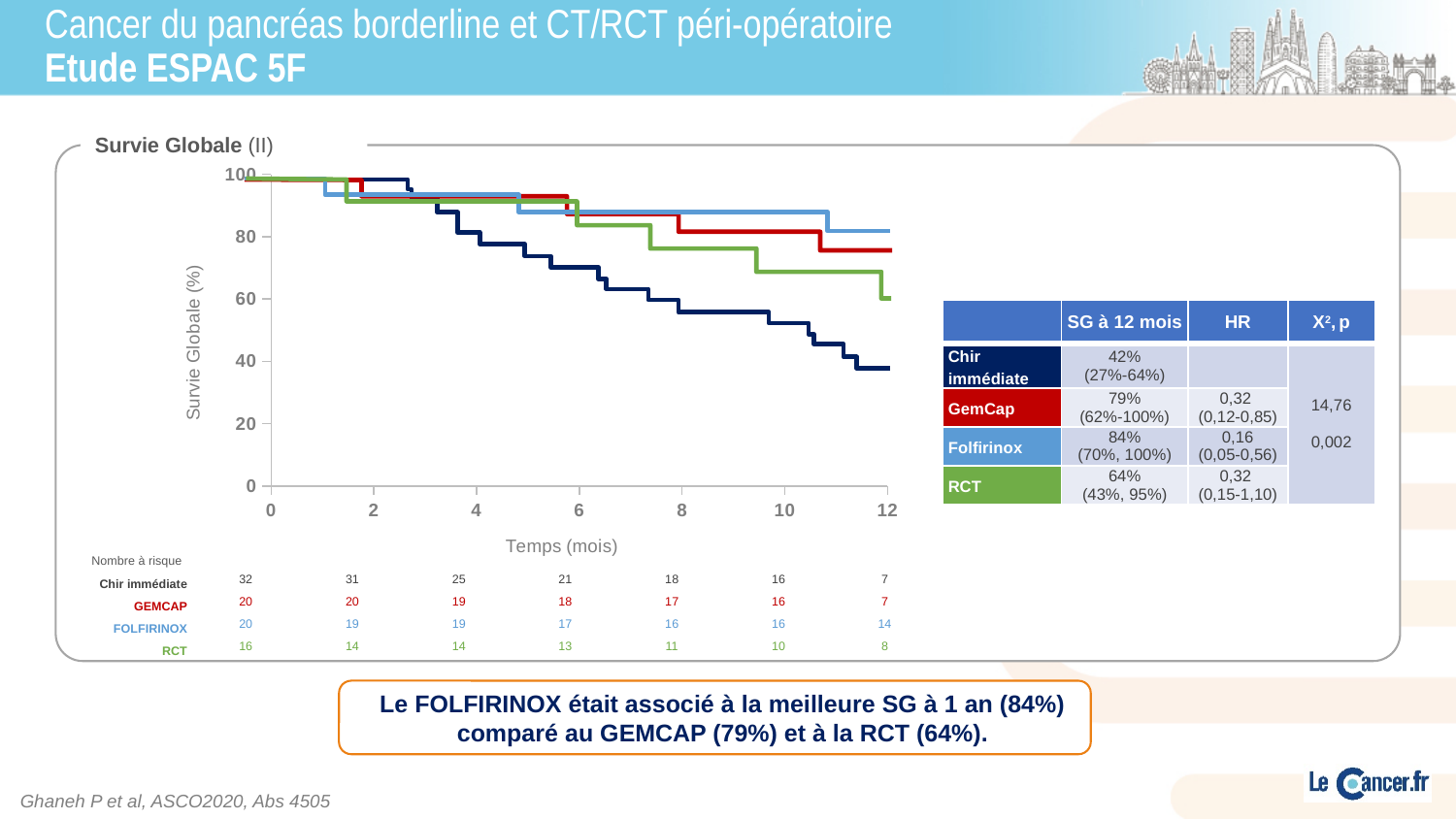
According to the table, what is the overall survival at 12 months for Chir immédiate? 42% How many treatment groups are plotted on the survival chart? 4 Is the Chir immédiate survival curve at 6 months greater or less than 60%? greater According to the table, what is the overall survival at 12 months (SG à 12 mois) for Folfirinox? 84% In the 'Nombre à risque' table, how many Chir immédiate patients are at risk at 0 months? 32 At 12 months, which group has the higher overall survival: GemCap or RCT? GemCap What is the difference in 12-month overall survival between Folfirinox (84%) and GemCap (79%)? 5 percentage points Do the survival curves rise or fall as time (Temps) increases? fall What kind of chart is shown in the 'Survie Globale' panel? line chart In the 'Nombre à risque' table, how many RCT patients are at risk at 12 months? 8 Which group has the lowest overall survival at 12 months? Chir immédiate Which group has the highest overall survival at 12 months? Folfirinox